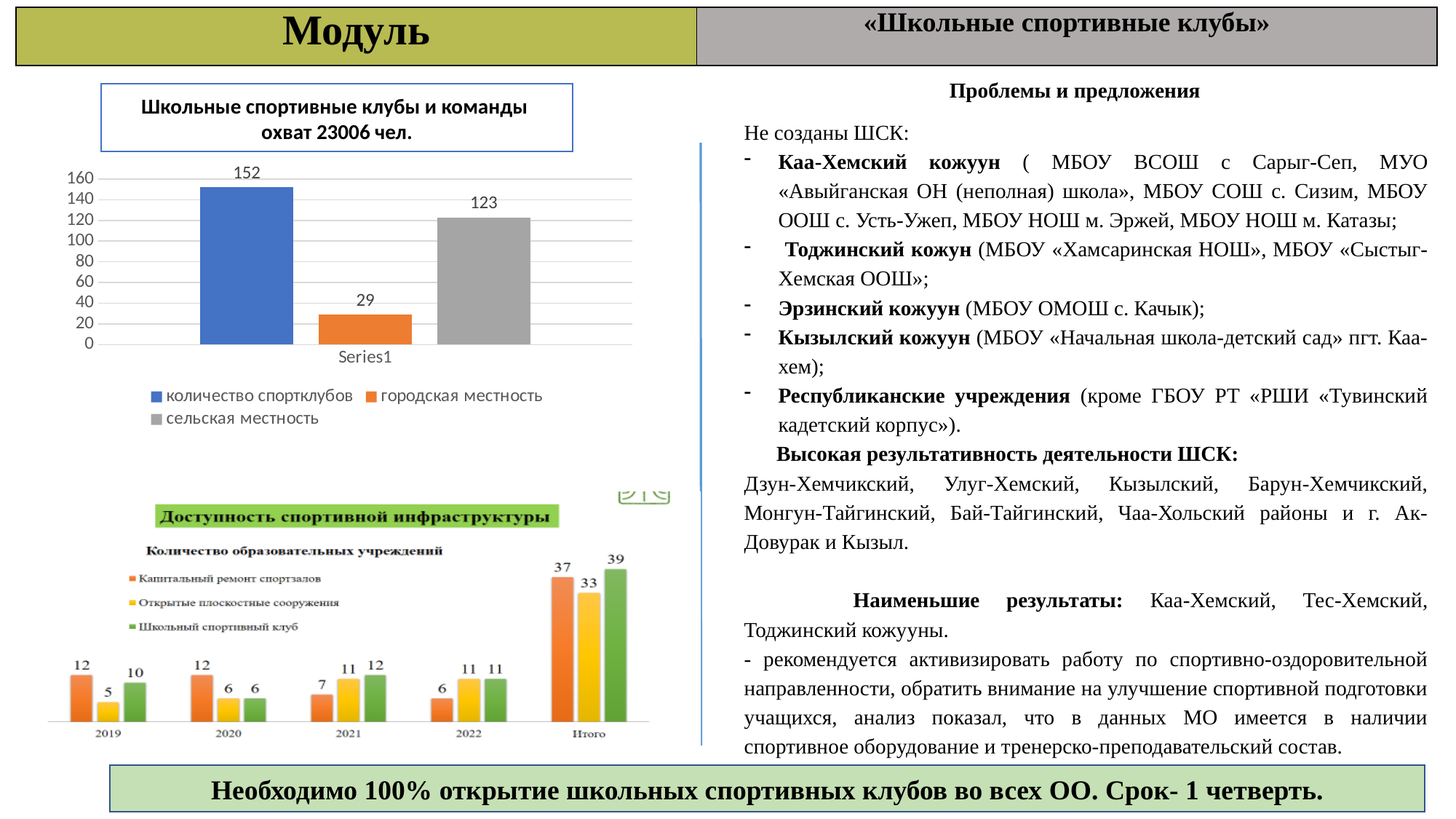
In the bottom chart 'Доступность спортивной инфраструктуры', which series has the highest 'Итого' value? Школьный спортивный клуб In the bottom chart 'Доступность спортивной инфраструктуры', what is the value for 'Капитальный ремонт спортзалов' in 'Итого'? 37 In the top chart 'Школьные спортивные клубы и команды', how many series does the legend list? 3 In the bottom chart 'Доступность спортивной инфраструктуры', is the value for 'Капитальный ремонт спортзалов' in 2019 larger or smaller than in 2022? larger In the top chart 'Школьные спортивные клубы и команды', what is the value for 'количество спортклубов'? 152 In the top chart 'Школьные спортивные клубы и команды', what is the difference between 'сельская местность' and 'городская местность'? 94 What type of chart is the top chart 'Школьные спортивные клубы и команды'? bar chart In the top chart 'Школьные спортивные клубы и команды', which series has the lowest value? городская местность In the top chart 'Школьные спортивные клубы и команды', what is the value for 'сельская местность'? 123 In the bottom chart 'Доступность спортивной инфраструктуры', how many categories are shown on the x axis? 5 In the bottom chart 'Доступность спортивной инфраструктуры', what is the difference between 'Открытые плоскостные сооружения' in 2021 and in 2019? 6 In the bottom chart 'Доступность спортивной инфраструктуры', what is the value for 'Школьный спортивный клуб' in 2021? 12